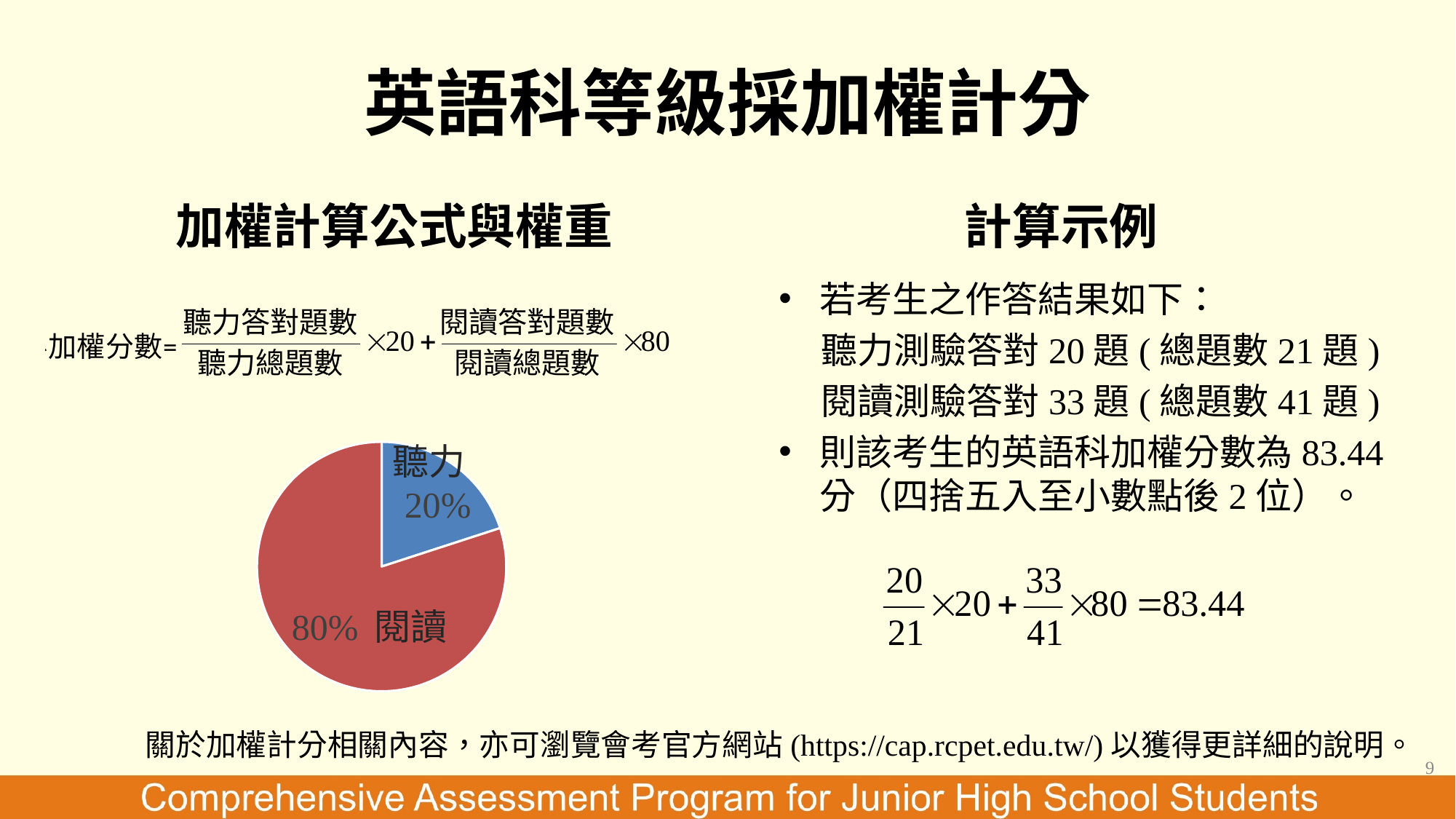
Which is larger in the pie chart, 聽力 or 閱讀? 閱讀 What kind of chart is shown on the slide? pie chart What share of the pie chart does 聽力 (listening) take? 20% How many slices does the pie chart have? 2 What share of the pie chart does 閱讀 (reading) take? 80% Which slice of the pie chart is the smallest? 聽力 Is the share for 閱讀 in the pie chart greater or less than 50%? greater Is the share for 聽力 in the pie chart greater or less than 50%? less What colour is the 閱讀 slice in the pie chart? red Which slice of the pie chart is the largest? 閱讀 What colour is the 聽力 slice in the pie chart? blue What is the difference in percentage points between the 閱讀 slice and the 聽力 slice? 60%